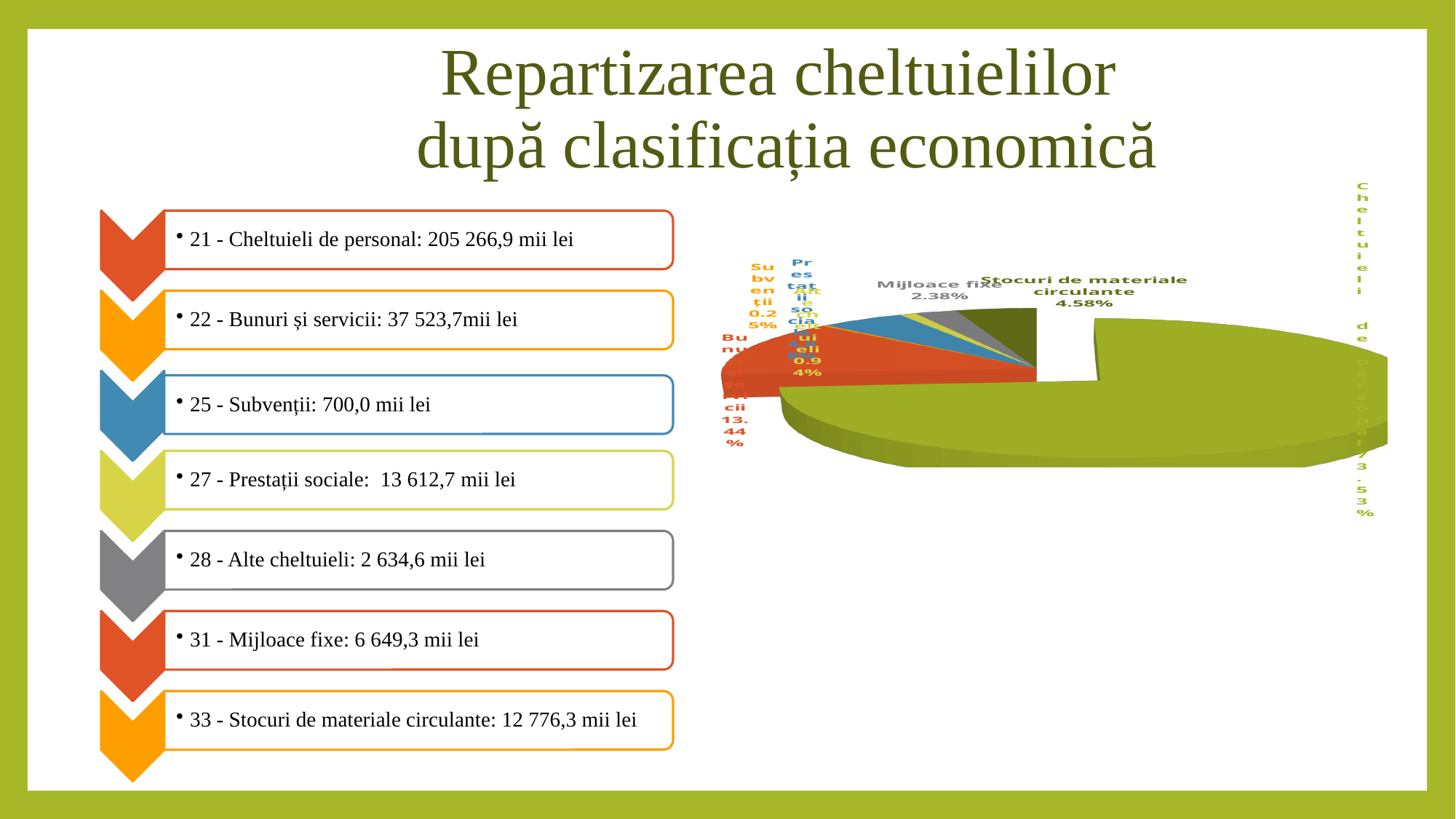
What percentage is shown for Mijloace fixe in the pie chart? 2.38% What kind of chart is shown on the slide? Pie chart By how many percentage points does Stocuri de materiale circulante exceed Mijloace fixe in the pie chart? 2.20 Which is larger in the pie chart: Mijloace fixe or Stocuri de materiale circulante? Stocuri de materiale circulante What percentage is shown for Stocuri de materiale circulante in the pie chart? 4.58% Which category has the largest share of the pie chart? Cheltuieli de personal By how many percentage points does Cheltuieli de personal exceed Bunuri și servicii in the pie chart? 60.09 What percentage is shown for Bunuri și servicii in the pie chart? 13.44% What colour is the largest slice of the pie chart? Green Which category has the smallest share in the pie chart? Subvenții What share of the pie chart does Cheltuieli de personal represent? 73.53% What percentage is shown for Subvenții in the pie chart? 0.25%